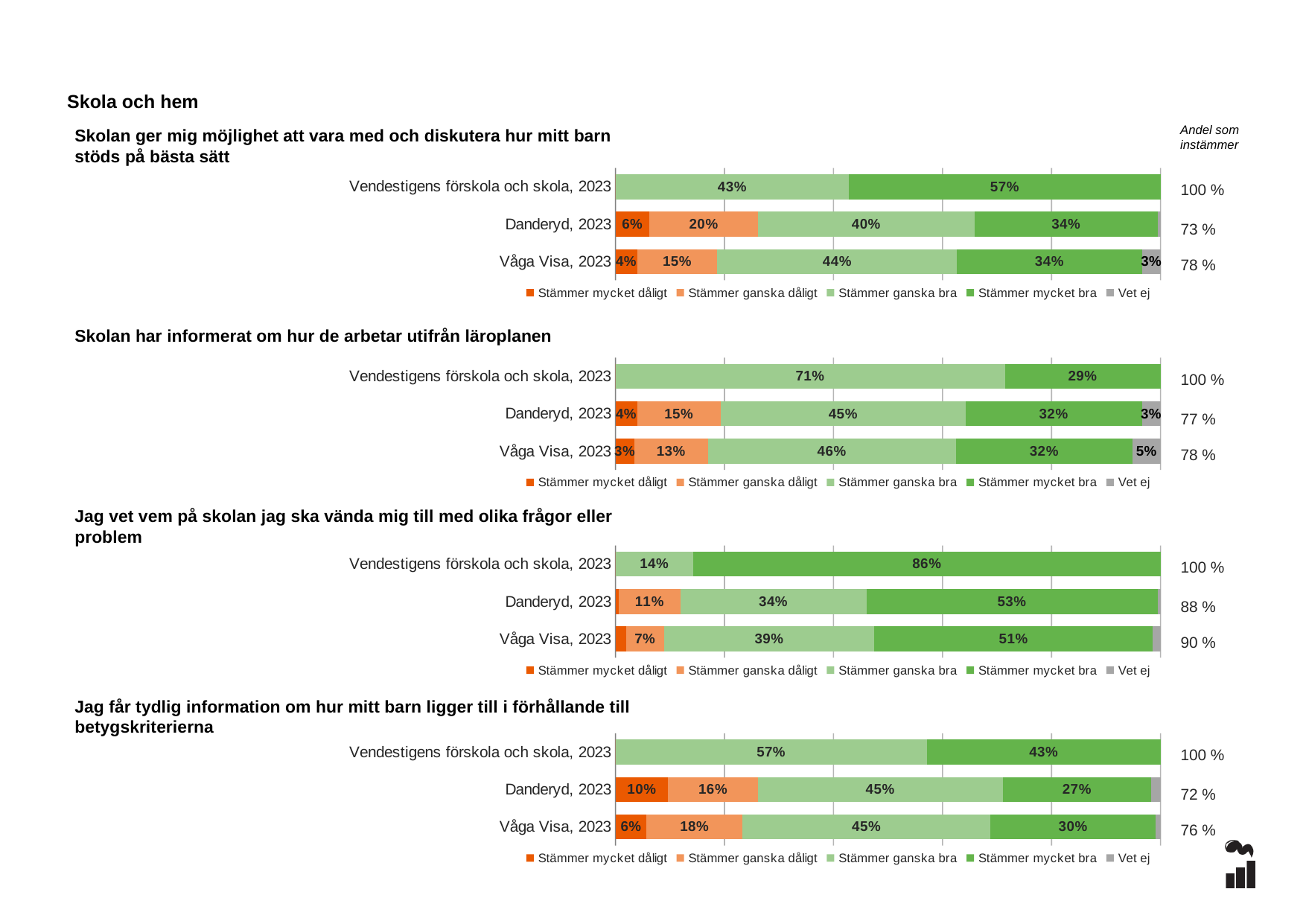
In the chart 'Skolan har informerat om hur de arbetar utifrån läroplanen', what is the 'Stämmer ganska bra' value for Vendestigens förskola och skola, 2023? 71% In the chart 'Skolan ger mig möjlighet att vara med och diskutera hur mitt barn stöds på bästa sätt', which has the higher 'Stämmer ganska bra' value: Danderyd, 2023 or Våga Visa, 2023? Våga Visa, 2023 In the chart 'Jag vet vem på skolan jag ska vända mig till med olika frågor eller problem', what is the 'Andel som instämmer' value for Våga Visa, 2023? 90 % In the chart 'Skolan ger mig möjlighet att vara med och diskutera hur mitt barn stöds på bästa sätt', what is the 'Stämmer ganska dåligt' value for Danderyd, 2023? 20% In the chart 'Jag vet vem på skolan jag ska vända mig till med olika frågor eller problem', which category has the highest 'Stämmer mycket bra' value? Vendestigens förskola och skola, 2023 In the chart 'Jag får tydlig information om hur mitt barn ligger till i förhållande till betygskriterierna', what is the difference between the 'Stämmer mycket bra' values for Våga Visa, 2023 and Danderyd, 2023? 3% In the chart 'Skolan har informerat om hur de arbetar utifrån läroplanen', what is the 'Vet ej' value for Våga Visa, 2023? 5% How many series does the legend list for the chart 'Skolan har informerat om hur de arbetar utifrån läroplanen'? 5 In the chart 'Skolan ger mig möjlighet att vara med och diskutera hur mitt barn stöds på bästa sätt', what is the 'Stämmer mycket bra' value for Vendestigens förskola och skola, 2023? 57% In the chart 'Jag får tydlig information om hur mitt barn ligger till i förhållande till betygskriterierna', what is the 'Stämmer mycket dåligt' value for Danderyd, 2023? 10% In the chart 'Jag vet vem på skolan jag ska vända mig till med olika frågor eller problem', what is the 'Stämmer mycket bra' value for Vendestigens förskola och skola, 2023? 86% What kind of chart is used for 'Jag får tydlig information om hur mitt barn ligger till i förhållande till betygskriterierna'? Stacked bar chart